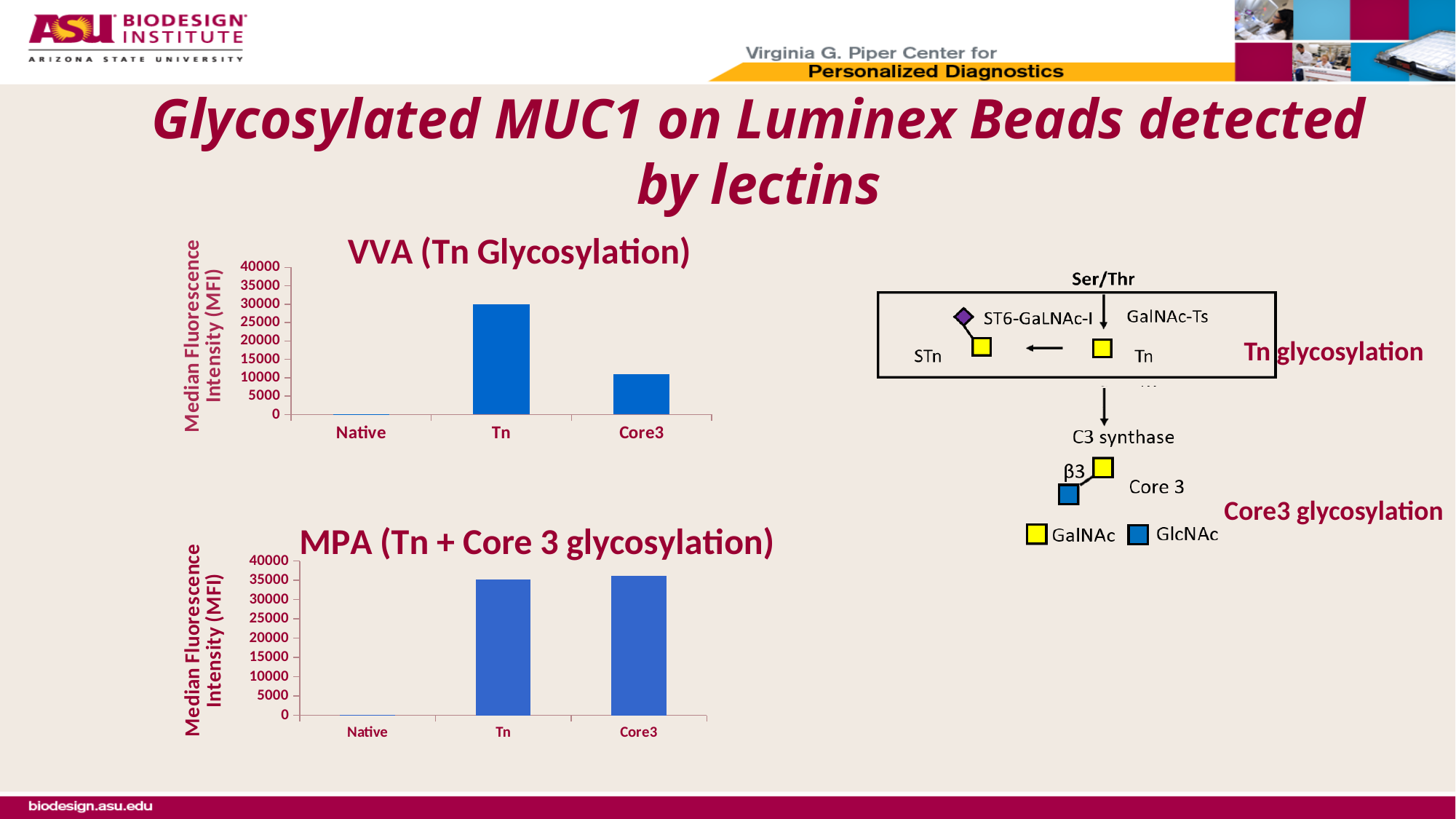
In the VVA (Tn Glycosylation) chart, which category has the highest median fluorescence intensity? Tn In the VVA (Tn Glycosylation) chart, is the value for Tn greater or less than 25000? greater In the VVA (Tn Glycosylation) chart, which is larger, the value for Tn or the value for Core3? Tn In the VVA (Tn Glycosylation) chart, which category has the lowest median fluorescence intensity? Native What kind of chart is the MPA (Tn + Core 3 glycosylation) chart? bar chart In the MPA (Tn + Core 3 glycosylation) chart, which category has the lowest median fluorescence intensity? Native In the VVA (Tn Glycosylation) chart, is the value for Core3 greater or less than 15000? less In the MPA (Tn + Core 3 glycosylation) chart, which is larger, the value for Native or the value for Tn? Tn In the MPA (Tn + Core 3 glycosylation) chart, is the value for Core3 greater or less than 30000? greater How many categories are shown on the x axis of the VVA (Tn Glycosylation) chart? 3 What is the y-axis label of the VVA (Tn Glycosylation) chart? Median Fluorescence Intensity (MFI)